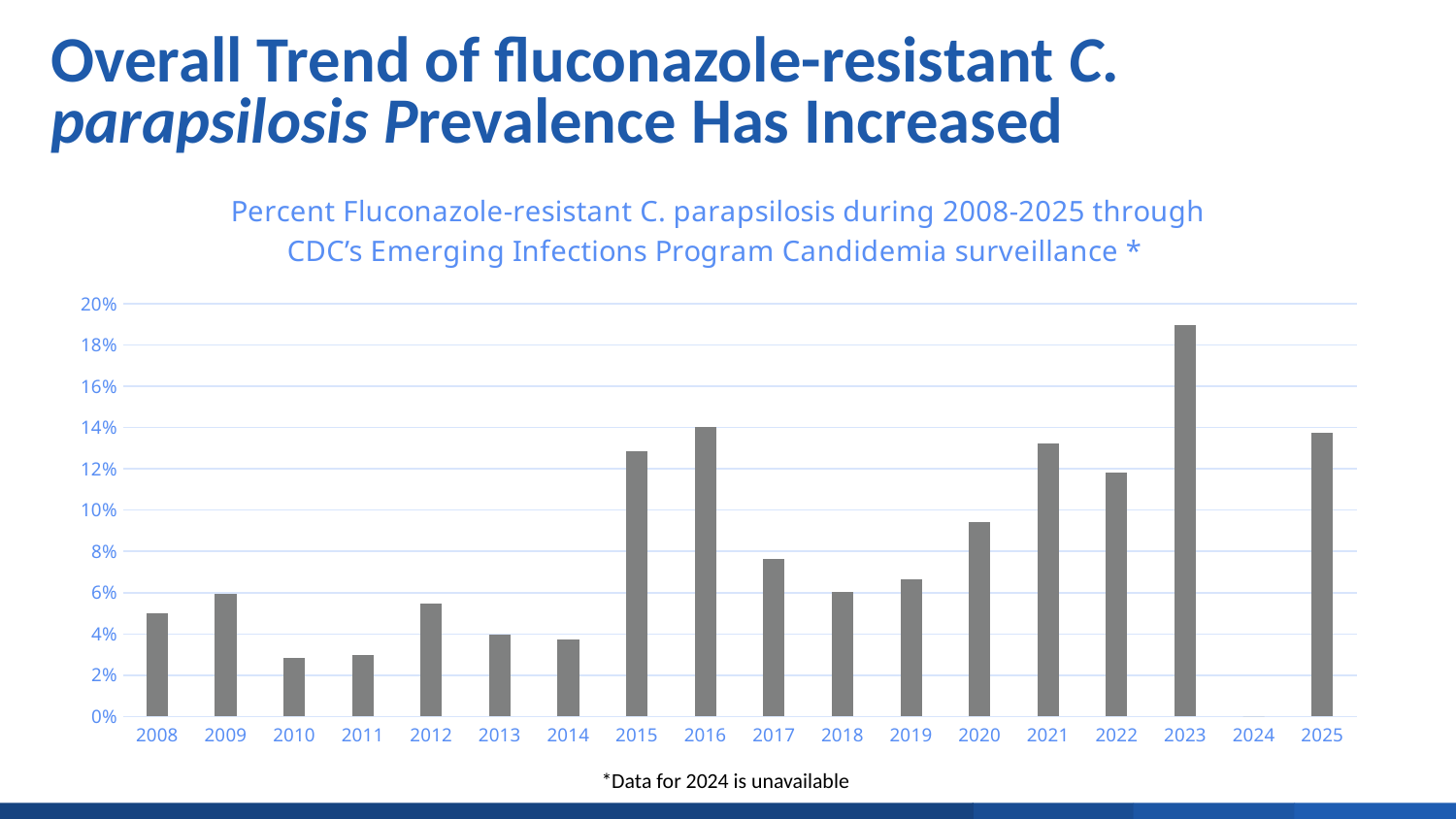
Which year has the larger value, 2015 or 2017? 2015 Which year has the highest percent of fluconazole-resistant C. parapsilosis? 2023 Is the value for 2010 greater or less than 4%? less How many years are labeled on the x axis? 18 What kind of chart is shown on the slide? bar chart Is the value for 2023 greater or less than 18%? greater Is the value for 2015 greater or less than 12%? greater Which year has the larger value, 2020 or 2021? 2021 Overall, do the values rise or fall from 2008 to 2025? rise According to the footnote, which year's data is unavailable? 2024